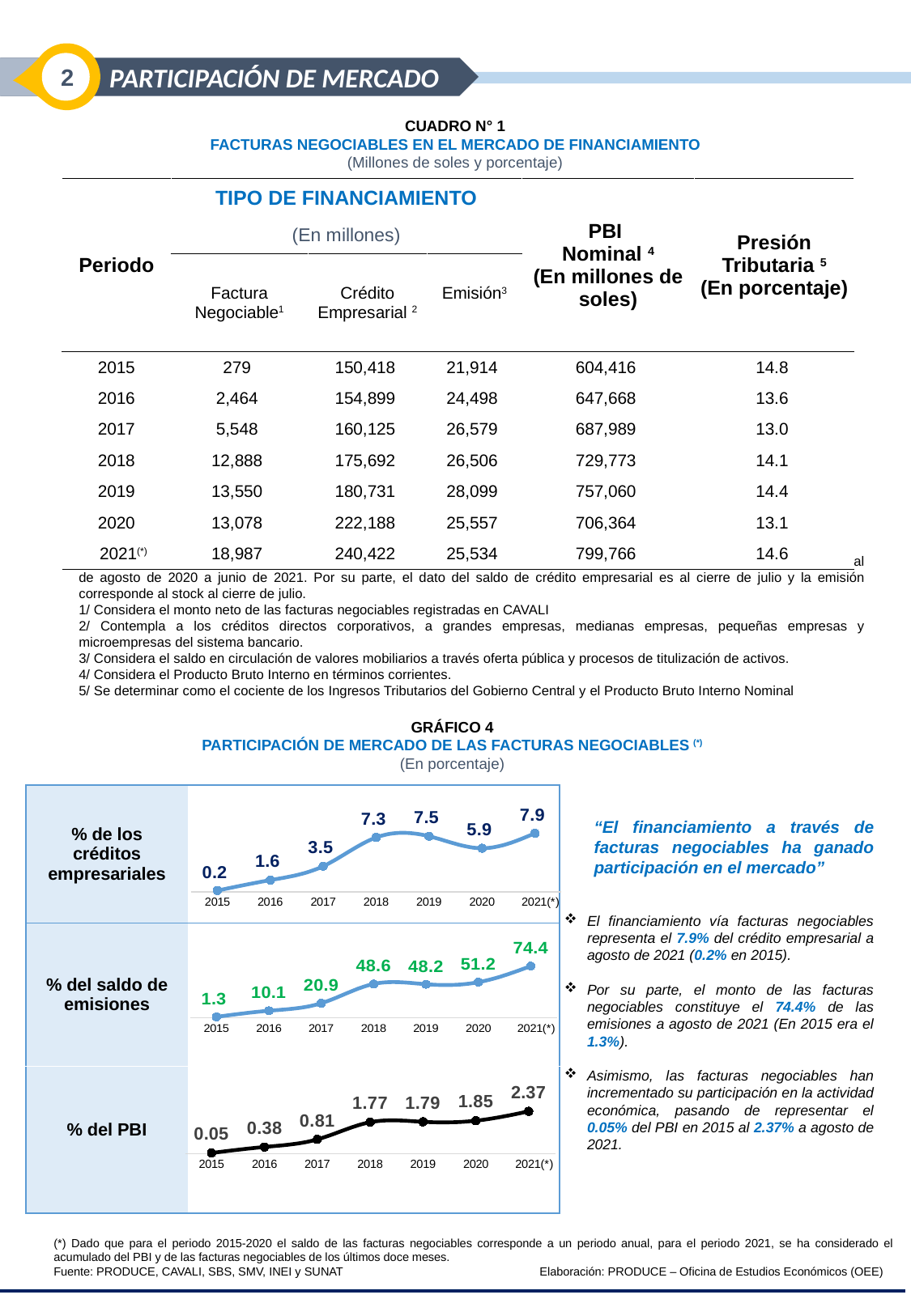
In Gráfico 4, what is the difference between the 2021(*) and 2015 values in the '% de los créditos empresariales' panel? 7.7 In Gráfico 4, which is larger in the '% del saldo de emisiones' panel: the value for 2018 or the value for 2019? 2018 In Gráfico 4, what is the value for 2018 in the '% de los créditos empresariales' panel? 7.3 In Gráfico 4, what is the value for 2021(*) in the '% del saldo de emisiones' panel? 74.4 What is the title of Gráfico 4? PARTICIPACIÓN DE MERCADO DE LAS FACTURAS NEGOCIABLES (*) In Gráfico 4, what is the value for 2017 in the '% del PBI' panel? 0.81 In Gráfico 4, what kind of chart is used in the '% de los créditos empresariales' panel? line chart In Gráfico 4, how many years are plotted in the '% del PBI' panel? 7 In Gráfico 4, which year has the lowest value in the '% del PBI' panel? 2015 In Gráfico 4, which year has the highest value in the '% del saldo de emisiones' panel? 2021(*) In Gráfico 4, what is the difference between the 2020 and 2019 values in the '% de los créditos empresariales' panel? 1.6 In Gráfico 4, do the values in the '% del PBI' panel generally rise or fall from 2015 to 2021(*)? rise